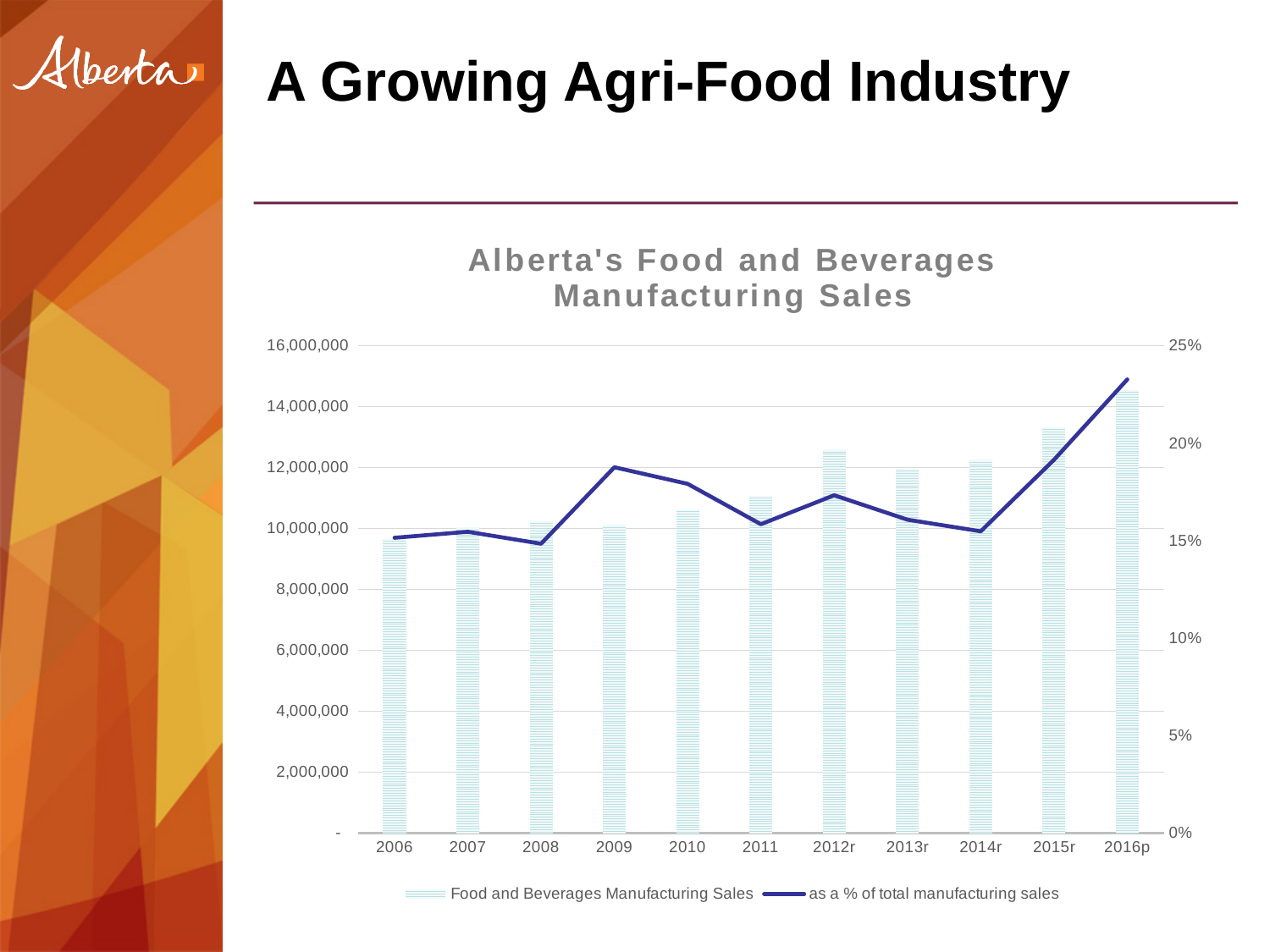
Which year has the lowest Food and Beverages Manufacturing Sales bar? 2006 Is the Food and Beverages Manufacturing Sales value for 2006 greater or less than 10,000,000? less Is the Food and Beverages Manufacturing Sales value for 2016p greater or less than 14,000,000? greater Which year has the highest 'as a % of total manufacturing sales' value? 2016p What is the title of the chart? Alberta's Food and Beverages Manufacturing Sales How many series does the chart's legend list? 2 Which year has the highest Food and Beverages Manufacturing Sales bar? 2016p How many years are shown on the x axis of the chart? 11 What kind of chart is shown on the slide? Combined bar and line chart Which is larger, the Food and Beverages Manufacturing Sales bar for 2012r or for 2013r? 2012r Is the 'as a % of total manufacturing sales' value for 2016p greater or less than 20%? greater Overall, do the Food and Beverages Manufacturing Sales bars rise or fall from 2006 to 2016p? rise